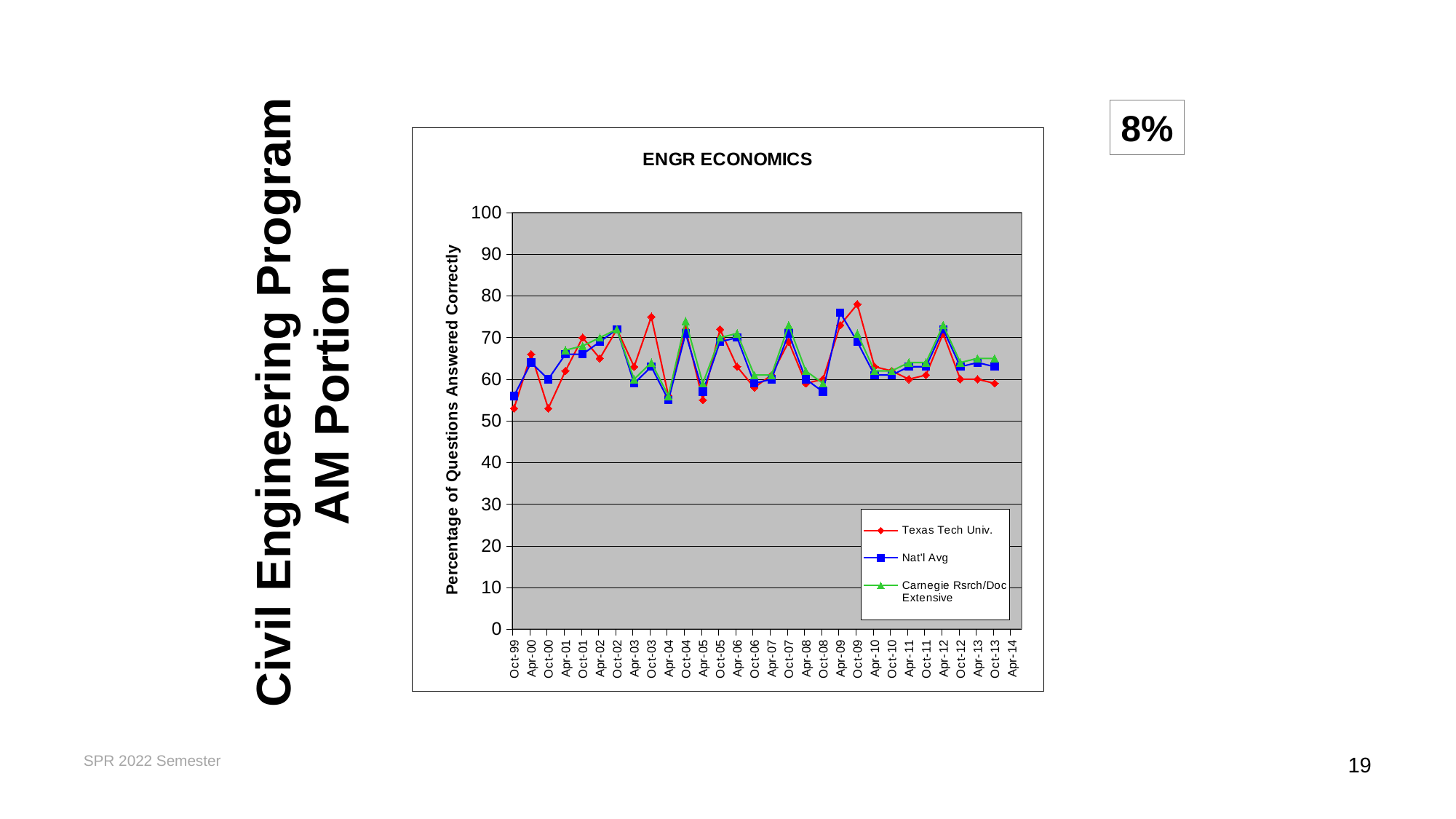
Is the value for Carnegie Rsrch/Doc Extensive at Oct-04 greater or less than 70? greater At Oct-03, which is larger: the value for Texas Tech Univ. or the value for Nat'l Avg? Texas Tech Univ. How many series does the legend of the ENGR ECONOMICS chart list? 3 What is the label on the vertical axis of the chart? Percentage of Questions Answered Correctly Is the value for Nat'l Avg at Oct-99 greater or less than 60? less Is the value for Texas Tech Univ. at Oct-00 greater or less than 60? less At Oct-00, which is larger: the value for Texas Tech Univ. or the value for Nat'l Avg? Nat'l Avg What is the title of the chart? ENGR ECONOMICS What kind of chart is shown on the slide? line chart